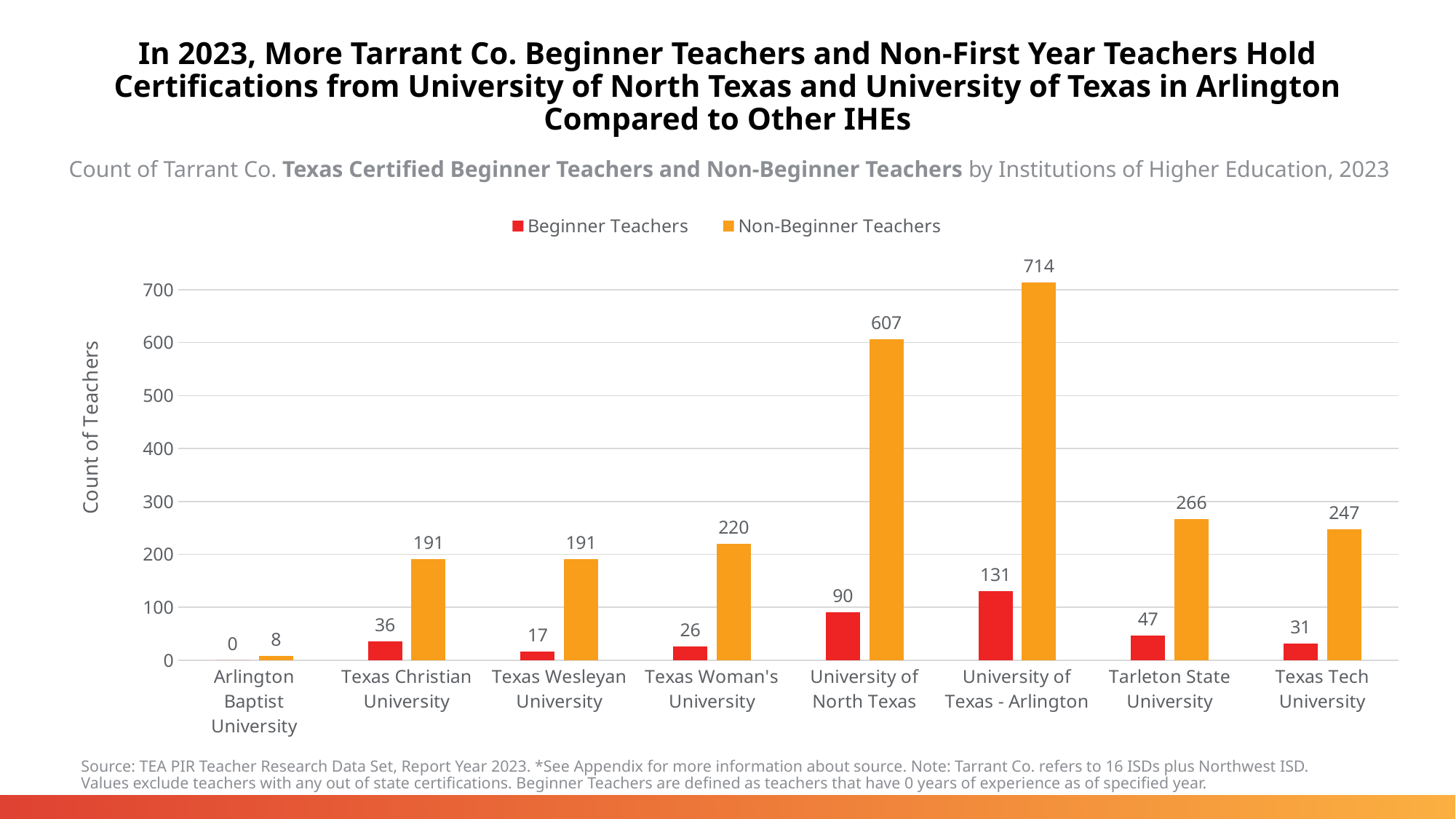
Which institution has the lowest number of Non-Beginner Teachers? Arlington Baptist University How many Beginner Teachers hold certifications from the University of Texas - Arlington? 131 How many Non-Beginner Teachers hold certifications from the University of North Texas? 607 Which institution has the highest number of Non-Beginner Teachers? University of Texas - Arlington Which has more Non-Beginner Teachers, Tarleton State University or Texas Tech University? Tarleton State University How many series does the legend list? 2 What kind of chart is shown on the slide? Bar chart What is the Beginner Teachers value for Arlington Baptist University? 0 What is the total of Beginner Teachers and Non-Beginner Teachers for Texas Christian University? 227 How many institutions are shown on the x axis? 8 Is the Non-Beginner Teachers value for Texas Woman's University greater or less than 200? greater What is the difference between the Non-Beginner Teachers values for University of Texas - Arlington and University of North Texas? 107